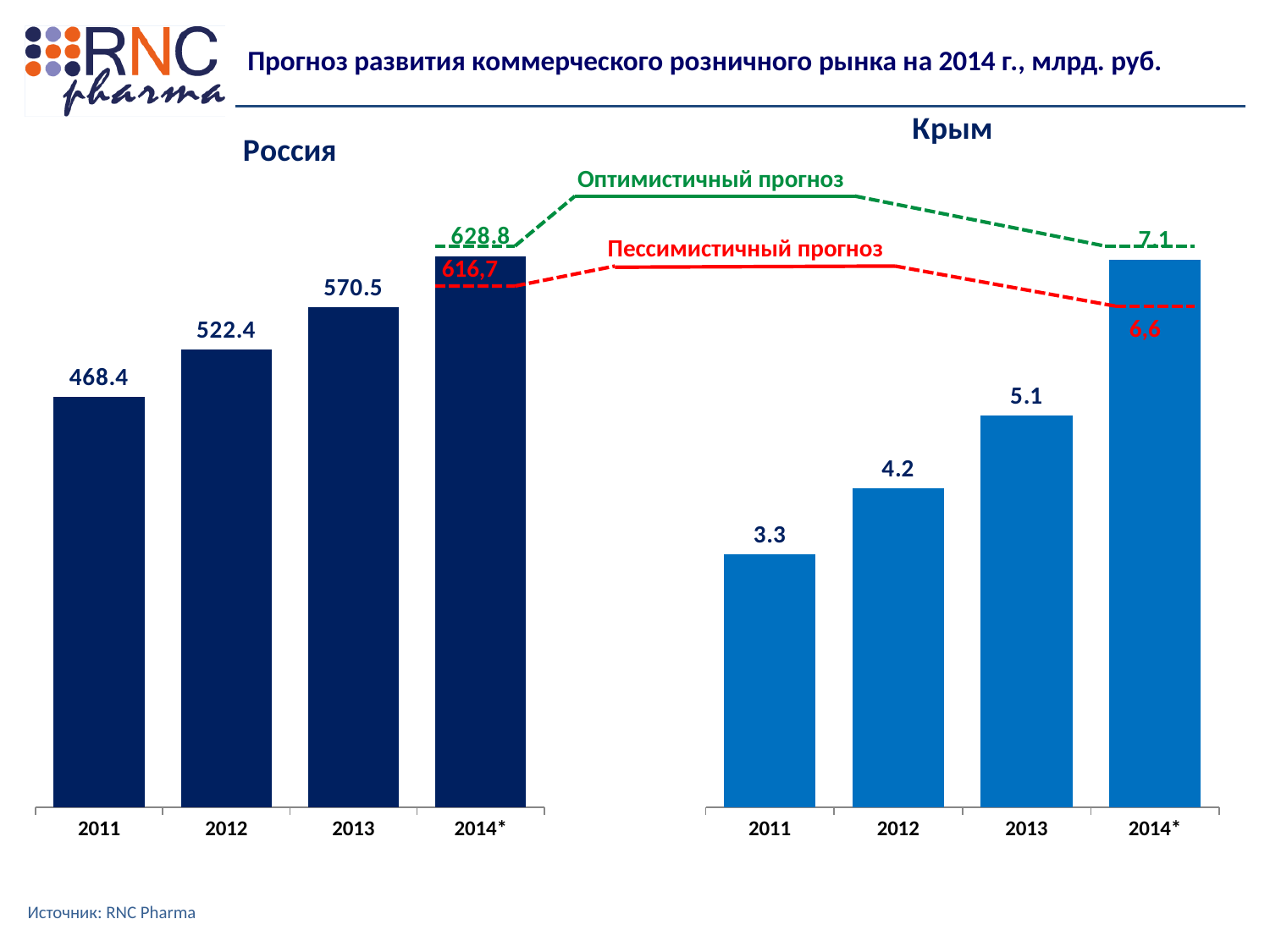
What kind of chart is the Россия chart? bar chart In the Россия chart, what is the value for 2011? 468.4 In the Крым chart, do the values rise or fall from 2011 to 2014*? rise In the Россия chart, what is the value for 2013? 570.5 In the Россия chart, which is larger: the value for 2012 or the value for 2011? 2012 In the Крым chart, what is the optimistic forecast (Оптимистичный прогноз) value for 2014*? 7.1 In the Крым chart, what is the difference between the 2013 and 2011 values? 1.8 How many years are shown on the x axis of the Крым chart? 4 In the Крым chart, which year has the lowest value? 2011 In the Россия chart, what is the difference between the 2013 and 2012 values? 48.1 In the Россия chart, what is the pessimistic forecast (Пессимистичный прогноз) value for 2014*? 616,7 In the Крым chart, what is the value for 2012? 4.2